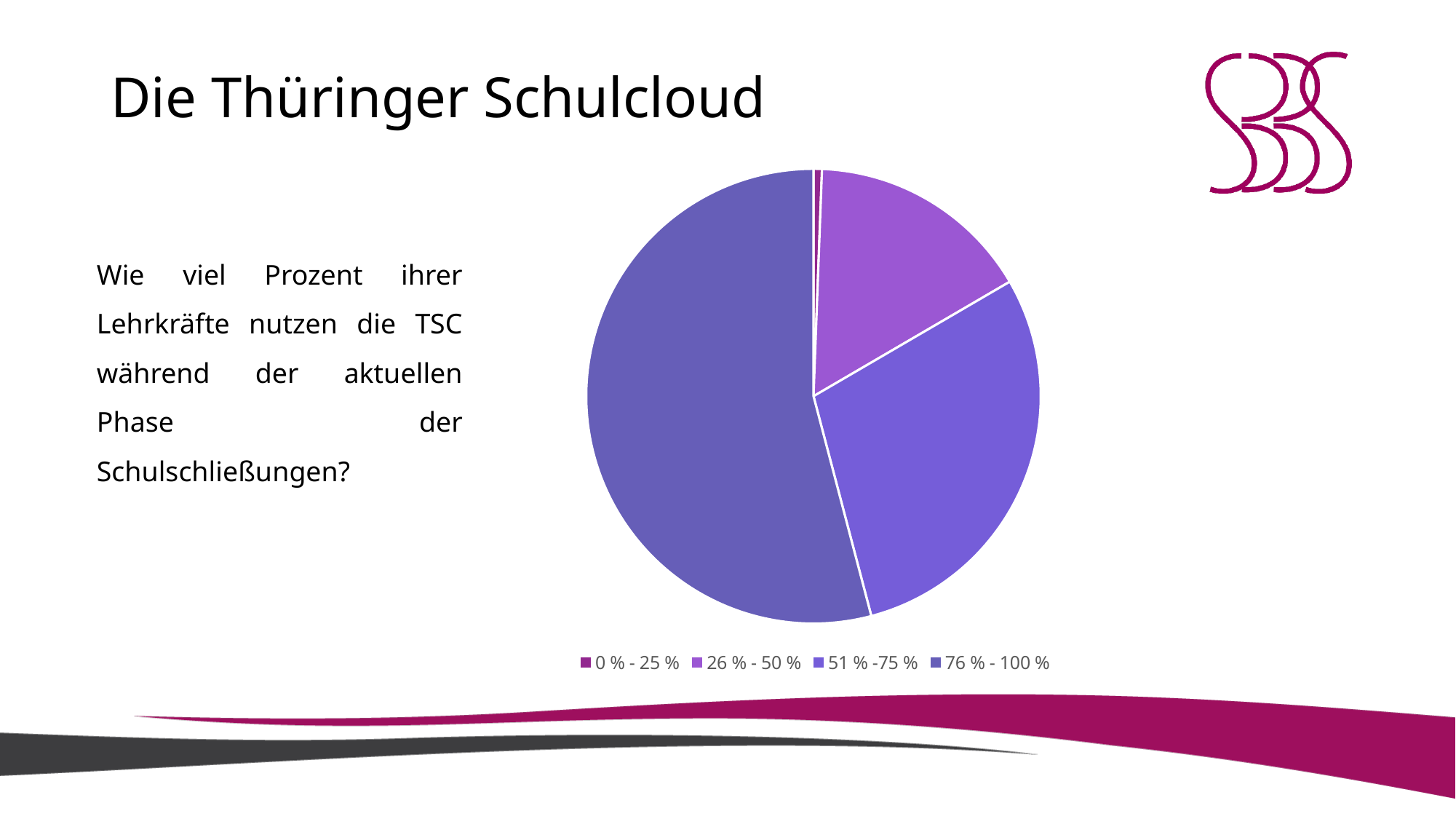
Which category has the largest slice in the pie chart? 76 % - 100 % Which category has the smallest slice in the pie chart? 0 % - 25 % Which category is the second-largest slice in the pie chart? 51 % -75 % Which slice is larger in the pie chart, 0 % - 25 % or 26 % - 50 %? 26 % - 50 % Which slice is larger in the pie chart, 76 % - 100 % or 51 % -75 %? 76 % - 100 % What is the first legend entry listed for the pie chart? 0 % - 25 % What kind of chart is shown on the slide? pie chart Which slice is larger in the pie chart, 26 % - 50 % or 51 % -75 %? 51 % -75 % How many slices does the pie chart have? 4 How many entries does the legend of the pie chart list? 4 Where is the legend of the pie chart placed relative to the pie? below the pie